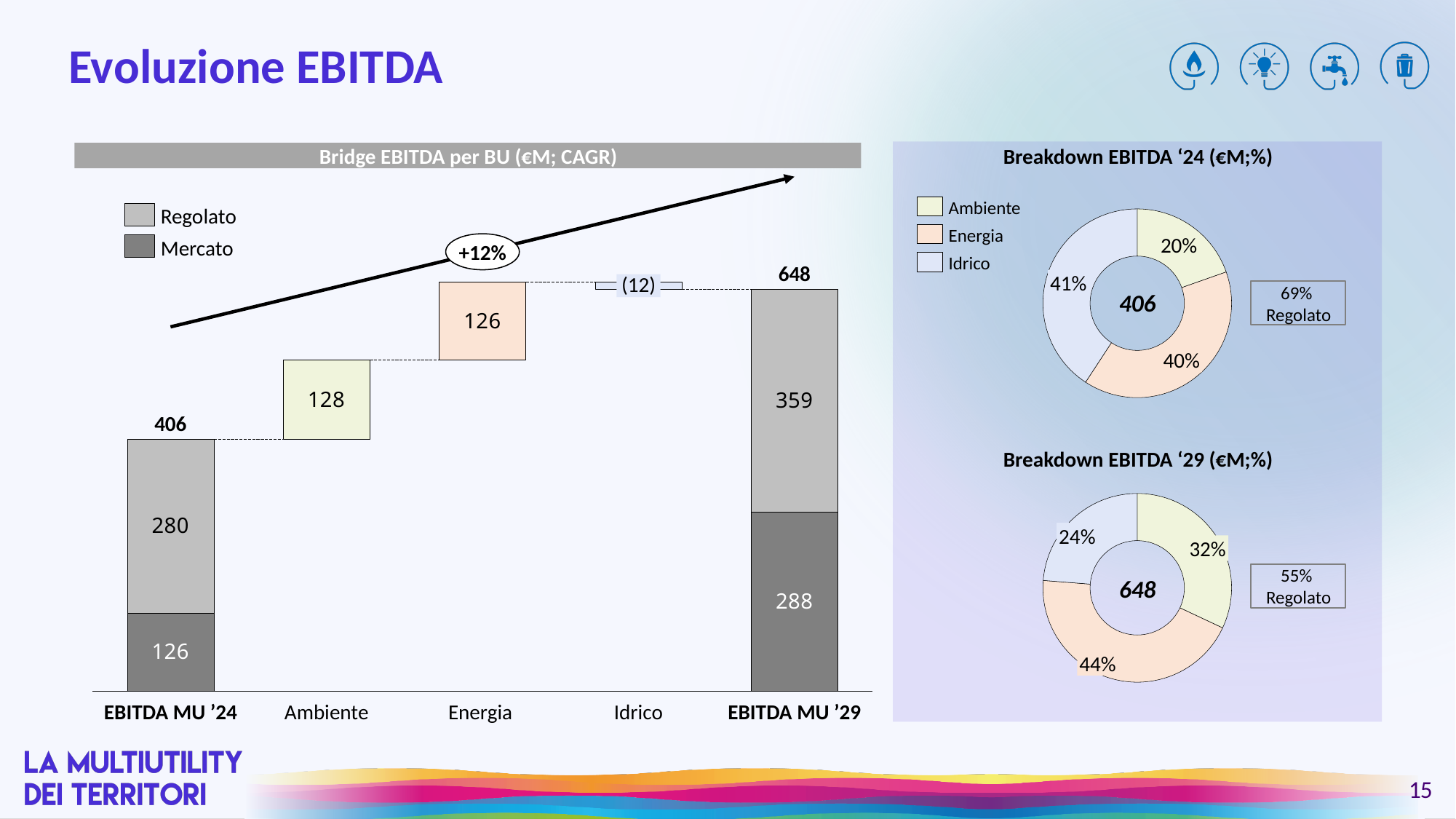
In the Breakdown EBITDA '29 chart, what share does Idrico have? 24% In the Bridge EBITDA per BU chart, what value is shown for Idrico? (12) In the Bridge EBITDA per BU chart, what is the total EBITDA MU '29? 648 What kind of chart is the Bridge EBITDA per BU chart? Bar chart In the Breakdown EBITDA '29 chart, which business unit has the largest share? Energia In the Breakdown EBITDA '24 chart, which business unit has the smallest share? Ambiente In the Bridge EBITDA per BU chart, which contributes more, Ambiente or Energia? Ambiente How many series does the legend of the Bridge EBITDA per BU chart list? 2 In the Bridge EBITDA per BU chart, what is the Regolato value for EBITDA MU '24? 280 In the Breakdown EBITDA '24 chart, what share does Energia have? 40% In the Bridge EBITDA per BU chart, what is the difference between the Regolato value for EBITDA MU '29 and the Regolato value for EBITDA MU '24? 79 In the Bridge EBITDA per BU chart, what is the Mercato value for EBITDA MU '29? 288